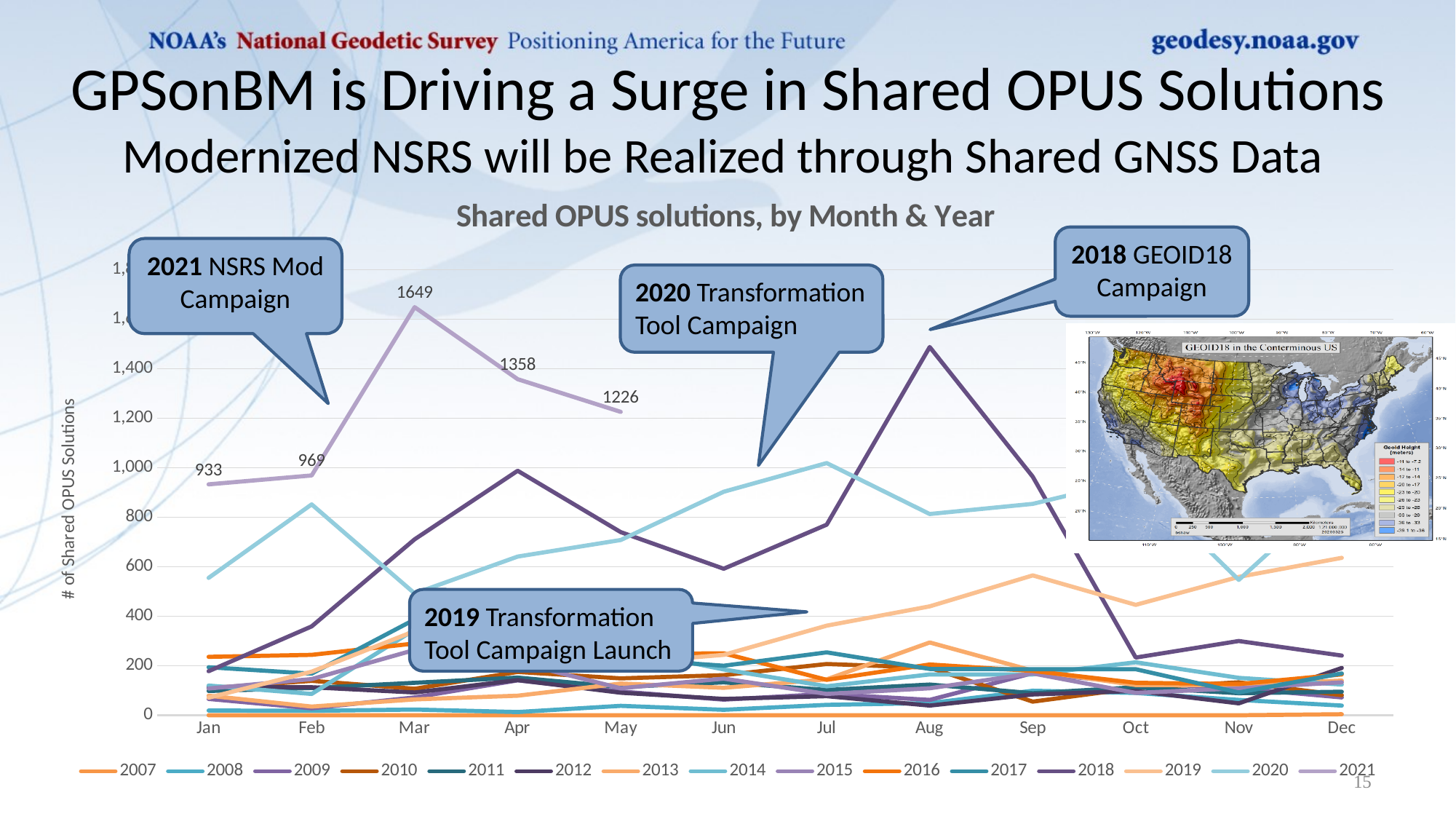
What is the number of shared OPUS solutions for 2021 in May? 1226 How many series (years) does the chart legend list? 15 What is the difference between the 2021 values for February and January? 36 What is the number of shared OPUS solutions for 2021 in January? 933 What kind of chart is shown on the slide? line chart How many months are shown along the x axis of the chart? 12 Is the 2020 value for July greater or less than 800? greater What is the difference between the 2021 values for March and April? 291 What is the number of shared OPUS solutions for 2021 in March? 1649 In which month does the 2021 series reach its highest value? Mar Is the 2018 value for August greater or less than 1,200? greater What is the title of the chart? Shared OPUS solutions, by Month & Year